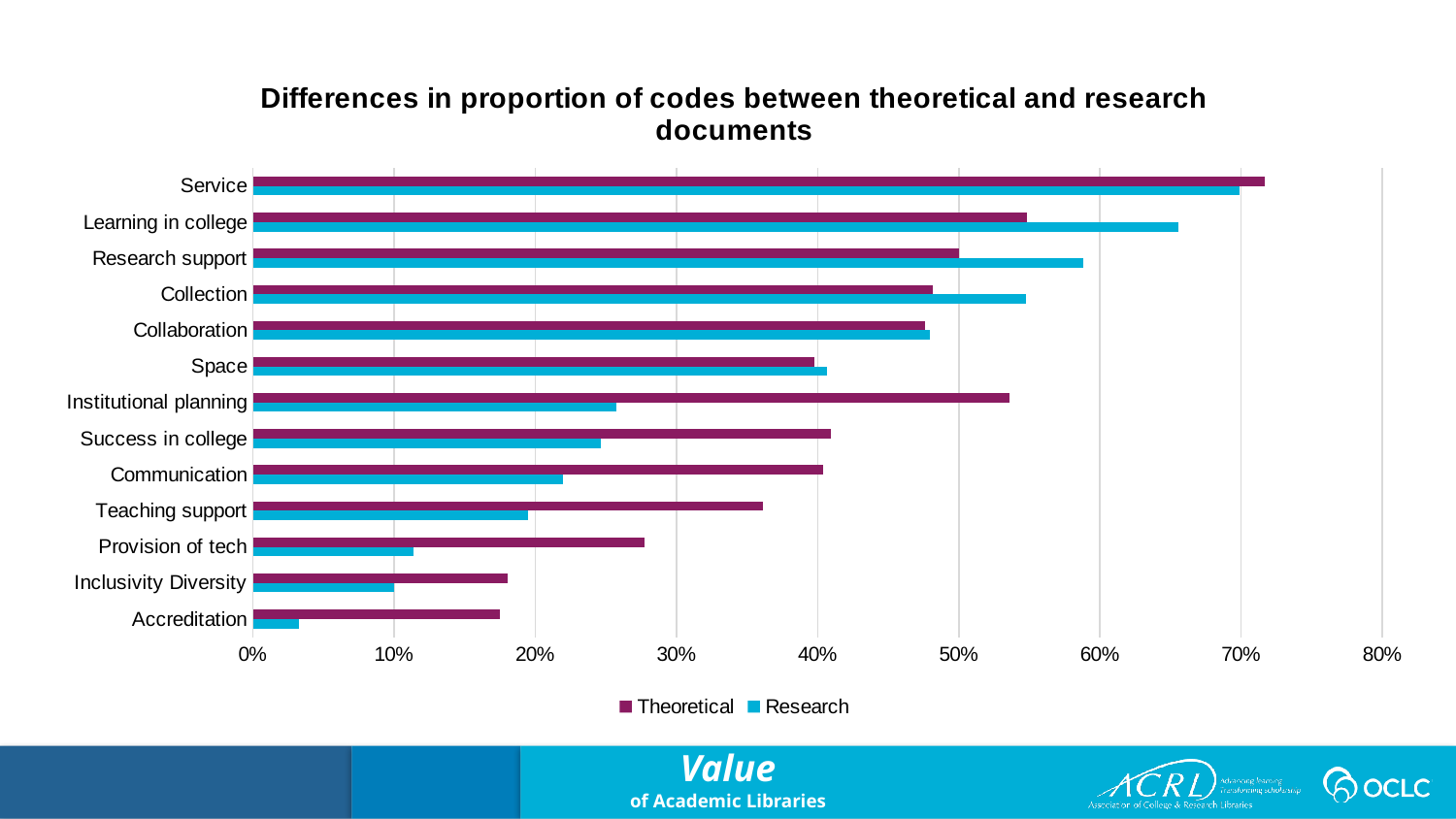
Is the Research value for Accreditation greater or less than 10%? less For Institutional planning, which is larger: the Theoretical value or the Research value? Theoretical What kind of chart is shown on the slide? Bar chart Is the Theoretical value for Institutional planning greater or less than 50%? greater Which category has the highest Research value? Service Is the Research value for Learning in college greater or less than 60%? greater Which category has the highest Theoretical value? Service For Collection, which is larger: the Theoretical value or the Research value? Research How many series does the legend list? 2 How many categories are plotted on the chart? 13 Which category has the lowest Research value? Accreditation